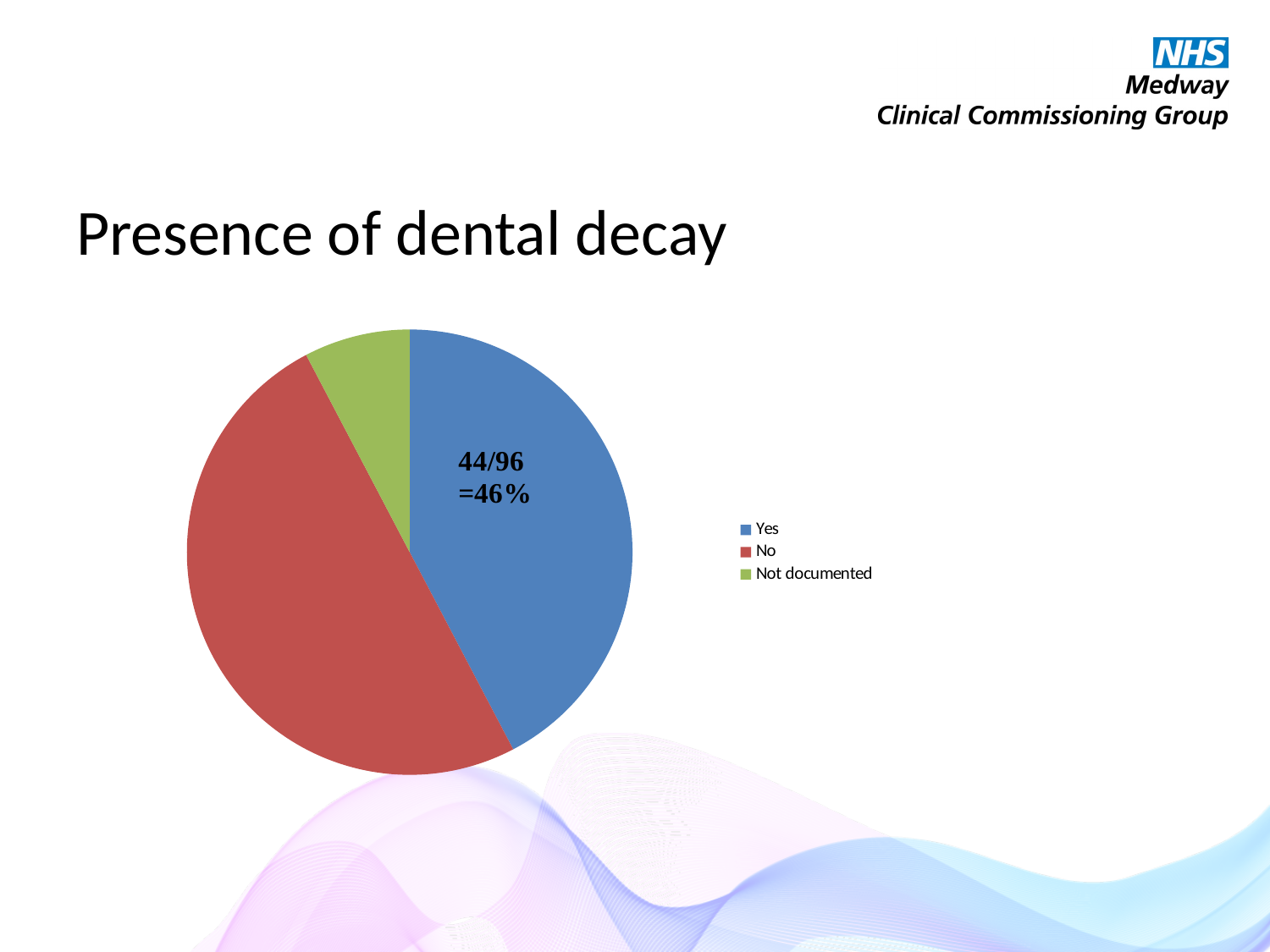
Which slice is larger, 'No' or 'Not documented'? No What kind of chart is shown on the slide? pie chart What percentage is shown for the 'Yes' slice? 46% How many slices does the pie chart have? 3 How many entries does the legend list? 3 What fraction is printed on the 'Yes' slice? 44/96 What colour is the 'Yes' slice in the pie chart? blue Which category has the smallest slice of the pie? Not documented What is the title of the chart on the slide? Presence of dental decay What share of the pie does the 'Yes' slice represent? 46% Which slice is larger, 'Yes' or 'Not documented'? Yes